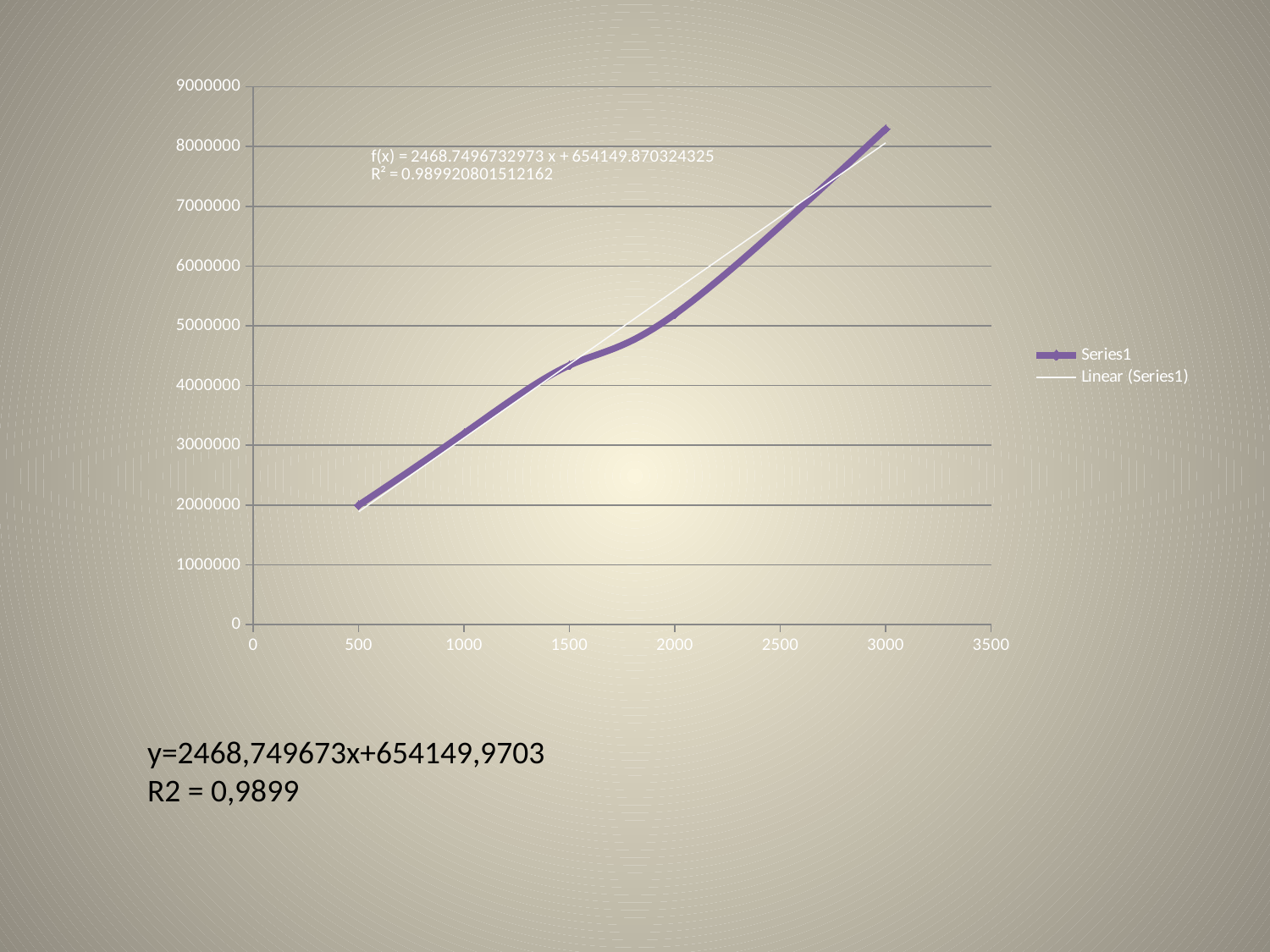
Which is larger, the value of Series1 at x = 1500 or at x = 3000? x = 3000 What is the maximum value shown on the y axis of the chart? 9000000 What is the R² value shown on the chart for the linear trendline? 0.989920801512162 At which x value does Series1 reach its highest value? 3000 Is the value of Series1 at x = 2000 greater or less than 6000000? less How many entries does the chart legend list? 2 Is the value of Series1 at x = 1500 greater or less than 4000000? greater What kind of chart is shown on the slide? line chart At which x value does Series1 have its lowest value? 500 Do the values of Series1 rise or fall as x increases from 500 to 3000? rise Is the value of Series1 at x = 500 greater or less than 3000000? less